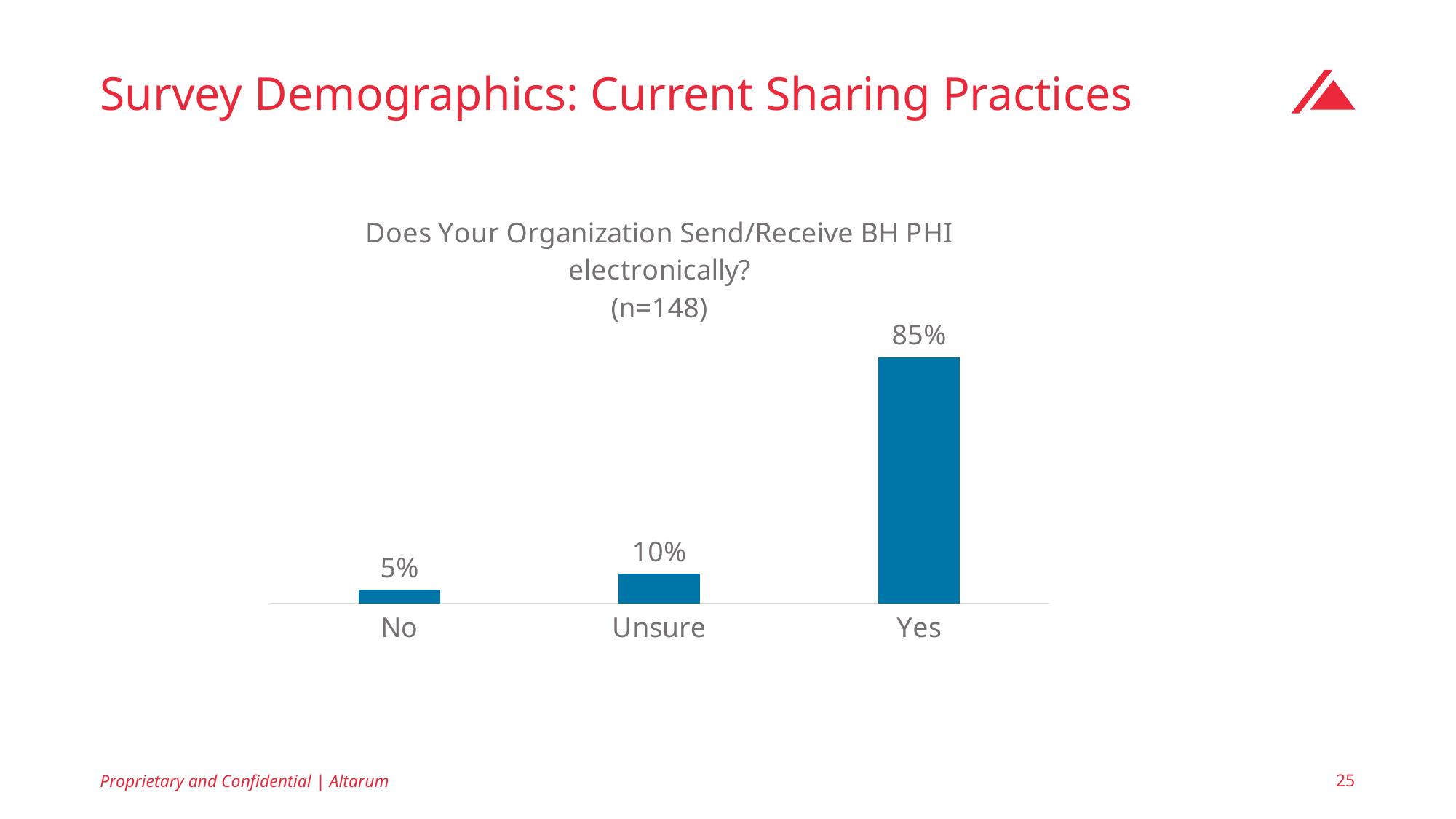
What percentage of respondents answered "Unsure"? 10% What percentage of respondents answered "Yes"? 85% Which response category has the highest value? Yes What percentage of respondents answered "No"? 5% What kind of chart is shown on the slide? Bar chart What is the title of the chart? Does Your Organization Send/Receive BH PHI electronically? (n=148) What is the difference between the "Unsure" and "No" percentages? 5% Which response category has the lowest value? No What is the difference between the "Yes" and "No" percentages? 80% How many response categories are shown on the chart? 3 Which is larger, the value for "Unsure" or the value for "No"? Unsure What is the sample size (n) stated in the chart title? 148